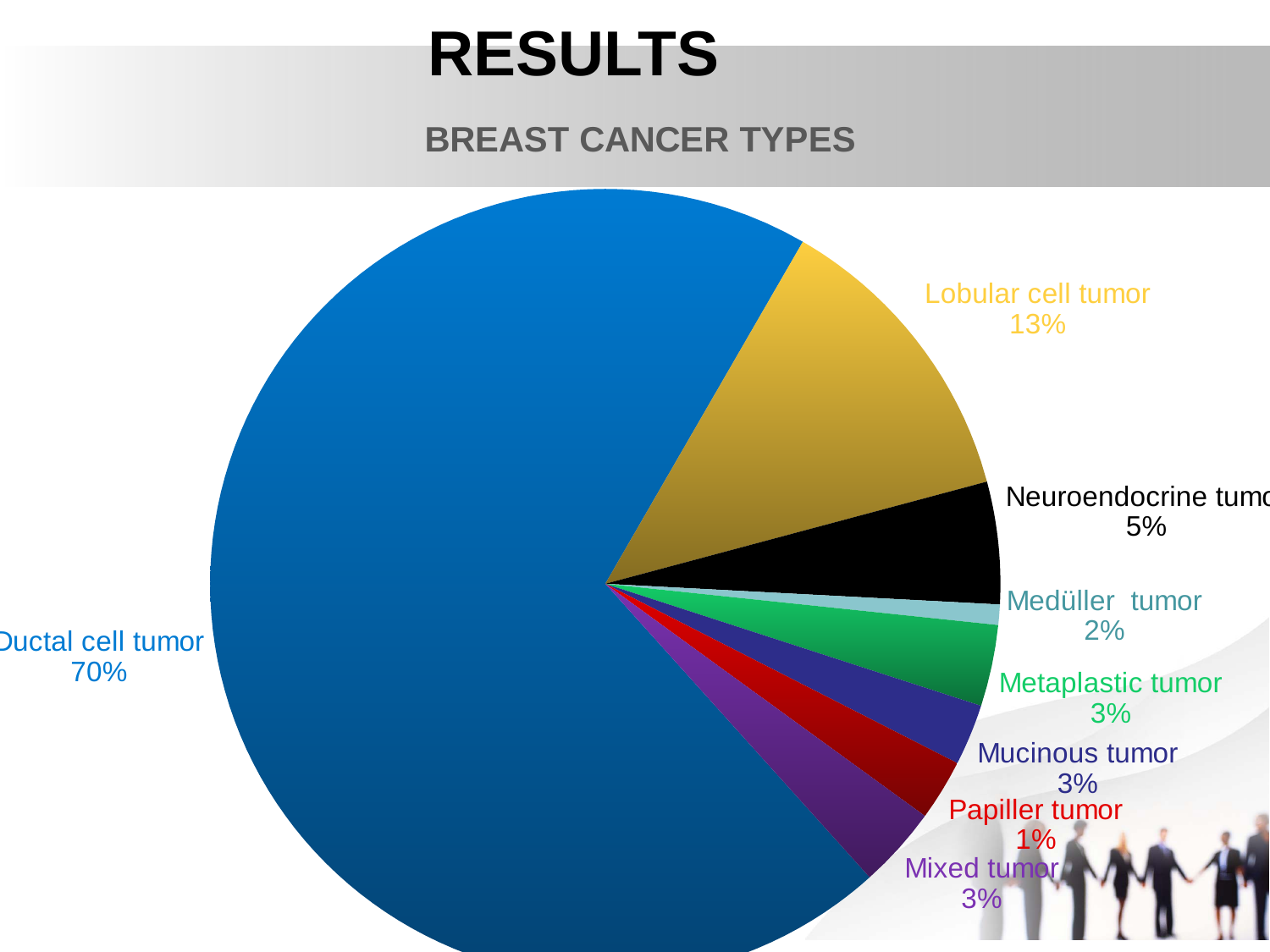
What percentage is shown for Medüller tumor? 2% What percentage is shown for Papiller tumor? 1% What percentage is shown for Lobular cell tumor? 13% What kind of chart is shown on the slide? pie chart Which breast cancer type has the smallest slice of the pie? Papiller tumor Which is larger, the share for Neuroendocrine tumor or the share for Metaplastic tumor? Neuroendocrine tumor What colour is the slice for Lobular cell tumor? yellow What is the title of the chart? BREAST CANCER TYPES Which breast cancer type has the largest slice of the pie? Ductal cell tumor What share of the pie does Ductal cell tumor represent? 70% How many breast cancer types (slices) are shown in the pie chart? 8 What is the difference in percentage points between Ductal cell tumor and Lobular cell tumor? 57